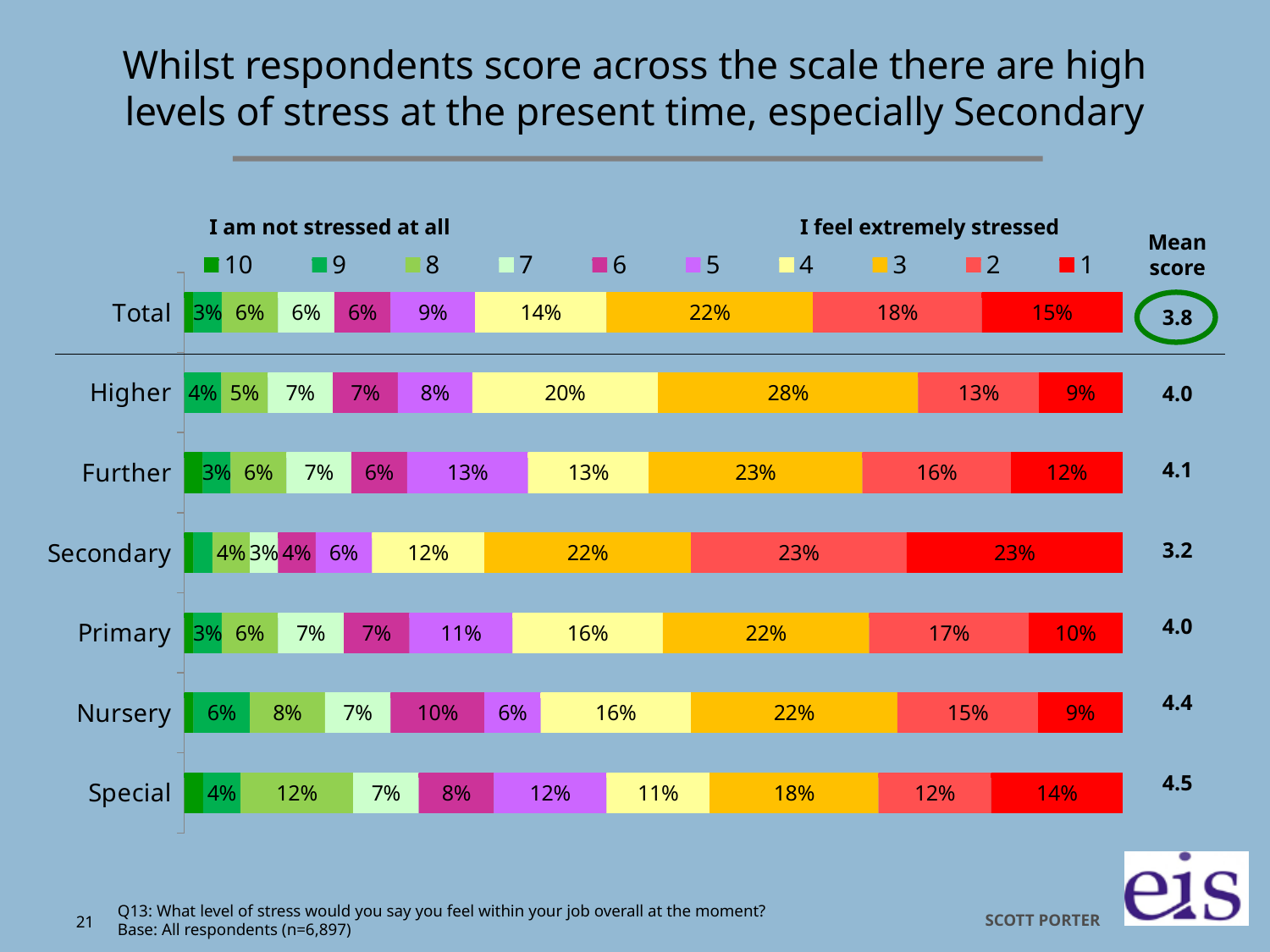
Which category has the highest percentage giving a score of 1? Secondary What percentage of Higher respondents gave a score of 4? 20% What is the mean score shown for Nursery? 4.4 Which category has the lowest mean score? Secondary Which has a larger share giving a score of 5: Further or Primary? Further What percentage of Total respondents gave a stress score of 3? 22% How many percentage points higher is the score-1 share for Secondary than for Higher? 14 percentage points What percentage of Special respondents gave a score of 9? 4% Which category has the highest percentage giving a score of 4? Higher What percentage of Secondary respondents gave a score of 1 (I feel extremely stressed)? 23% How many series does the legend list? 10 How many categories (rows) are plotted in the chart? 7